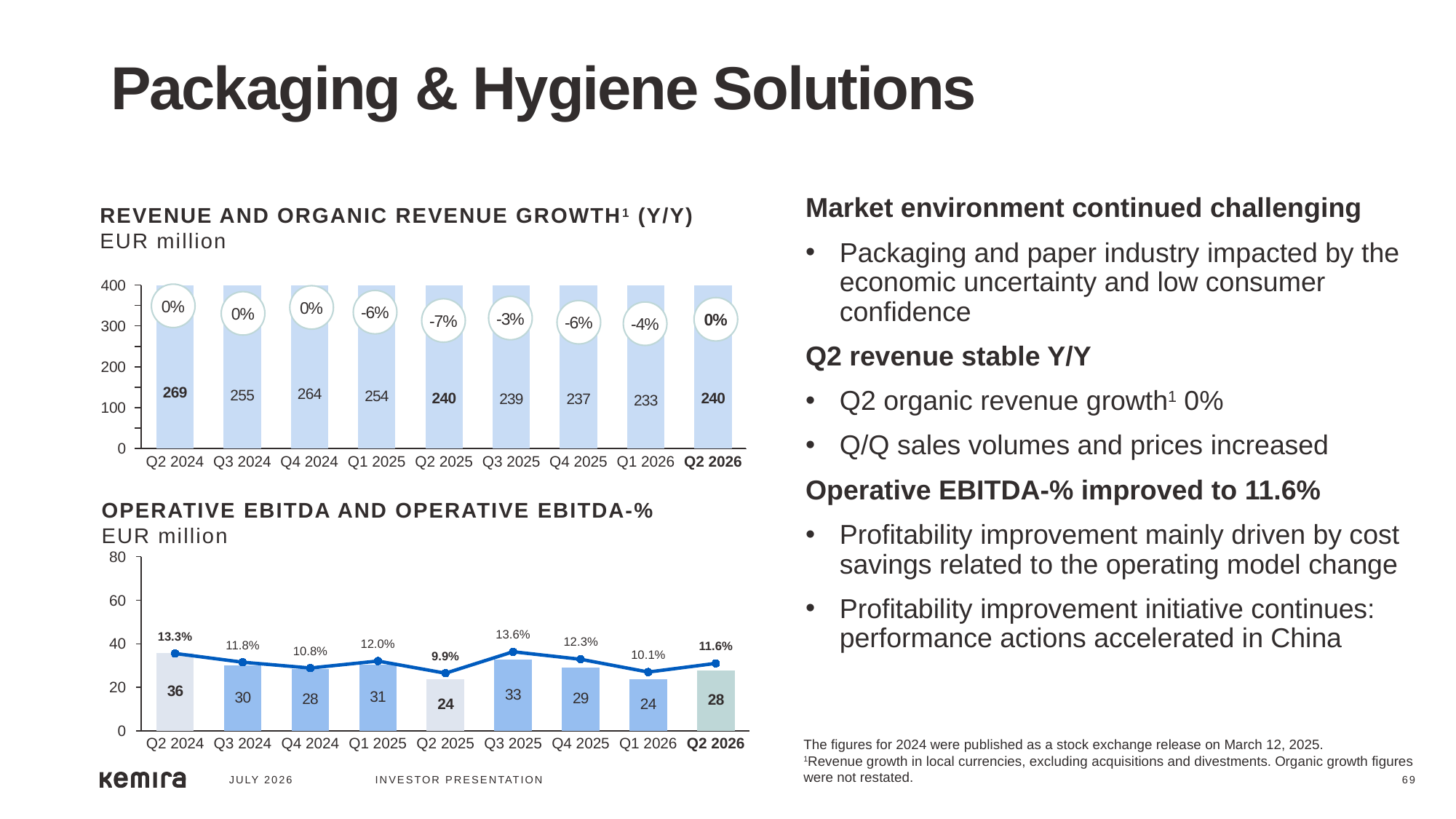
In the 'Operative EBITDA and operative EBITDA-%' chart, is the operative EBITDA for Q2 2024 larger or smaller than for Q2 2025? larger In the 'Revenue and organic revenue growth' chart, what is the revenue for Q2 2026? 240 In the 'Operative EBITDA and operative EBITDA-%' chart, what is the difference in operative EBITDA between Q2 2025 and Q2 2026? 4 In the 'Revenue and organic revenue growth' chart, how many quarters are shown? 9 In the 'Revenue and organic revenue growth' chart, which quarter has the lowest revenue? Q1 2026 In the 'Operative EBITDA and operative EBITDA-%' chart, which quarter has the lowest operative EBITDA-%? Q2 2025 In the 'Revenue and organic revenue growth' chart, what is the organic revenue growth for Q2 2025? -7% In the 'Operative EBITDA and operative EBITDA-%' chart, which quarter has the highest operative EBITDA-%? Q3 2025 In the 'Operative EBITDA and operative EBITDA-%' chart, what is the operative EBITDA for Q3 2025? 33 In the 'Operative EBITDA and operative EBITDA-%' chart, what is the operative EBITDA-% for Q2 2026? 11.6% In the 'Revenue and organic revenue growth' chart, what is the difference in revenue between Q2 2024 and Q2 2026? 29 In the 'Revenue and organic revenue growth' chart, which quarter has the highest revenue? Q2 2024